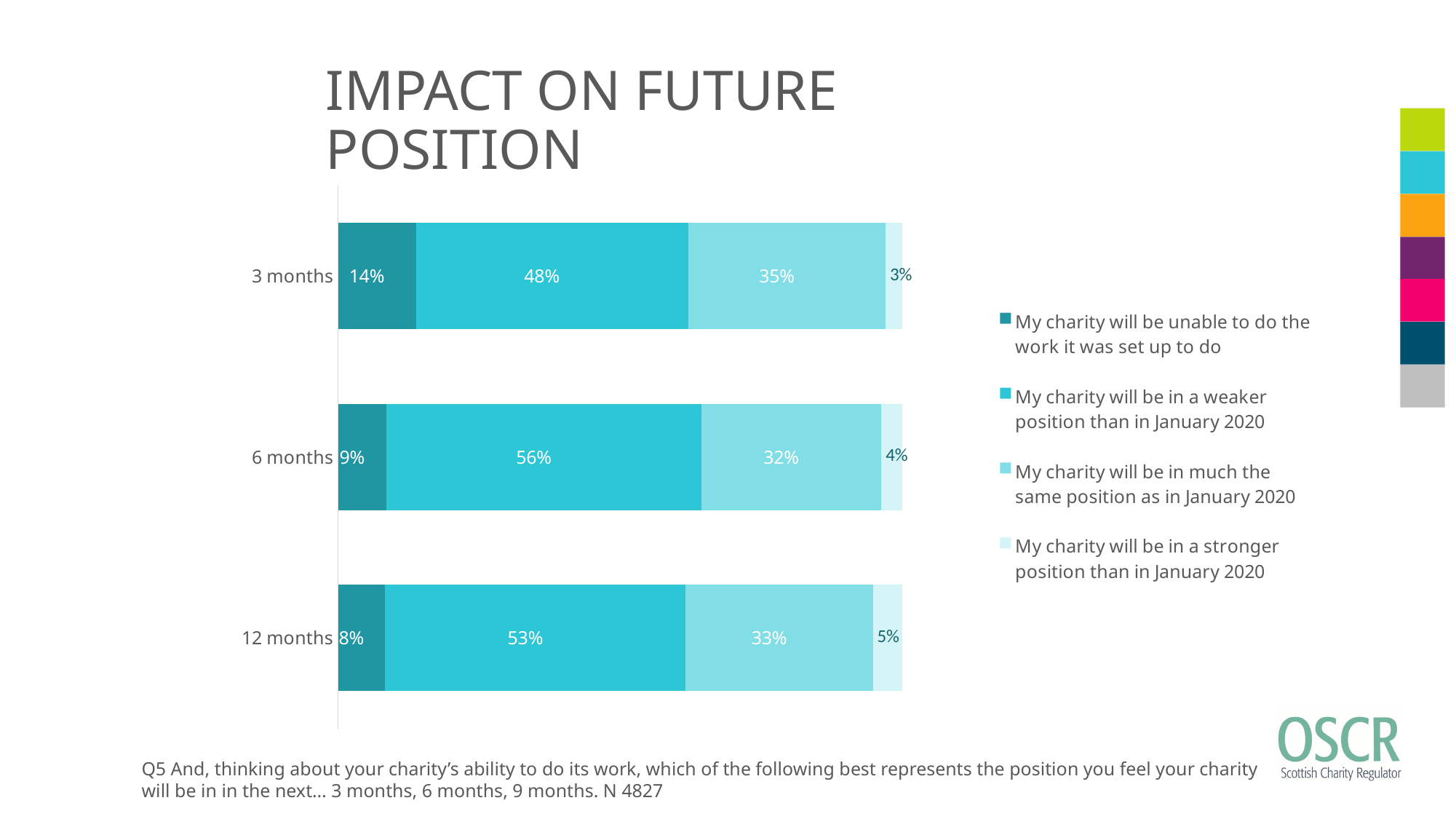
What is the difference between the 'weaker position' share at 6 months and at 3 months? 8 percentage points What kind of chart is shown on the slide? Stacked bar chart Which time period has the lowest share of charities saying they will be in a stronger position than in January 2020? 3 months How many series does the legend list? 4 What percentage of charities said they will be in much the same position as in January 2020 at 3 months? 35% What percentage of charities said they will be unable to do the work they were set up to do at 3 months? 14% How many time periods are shown on the chart? 3 What is the title of the slide? IMPACT ON FUTURE POSITION Is the 'much the same position' share larger at 3 months or at 12 months? 3 months Which time period has the highest share of charities saying they will be unable to do the work they were set up to do? 3 months What percentage of charities said they will be in a stronger position than in January 2020 at 12 months? 5% What percentage of charities said they will be in a weaker position than in January 2020 at 6 months? 56%